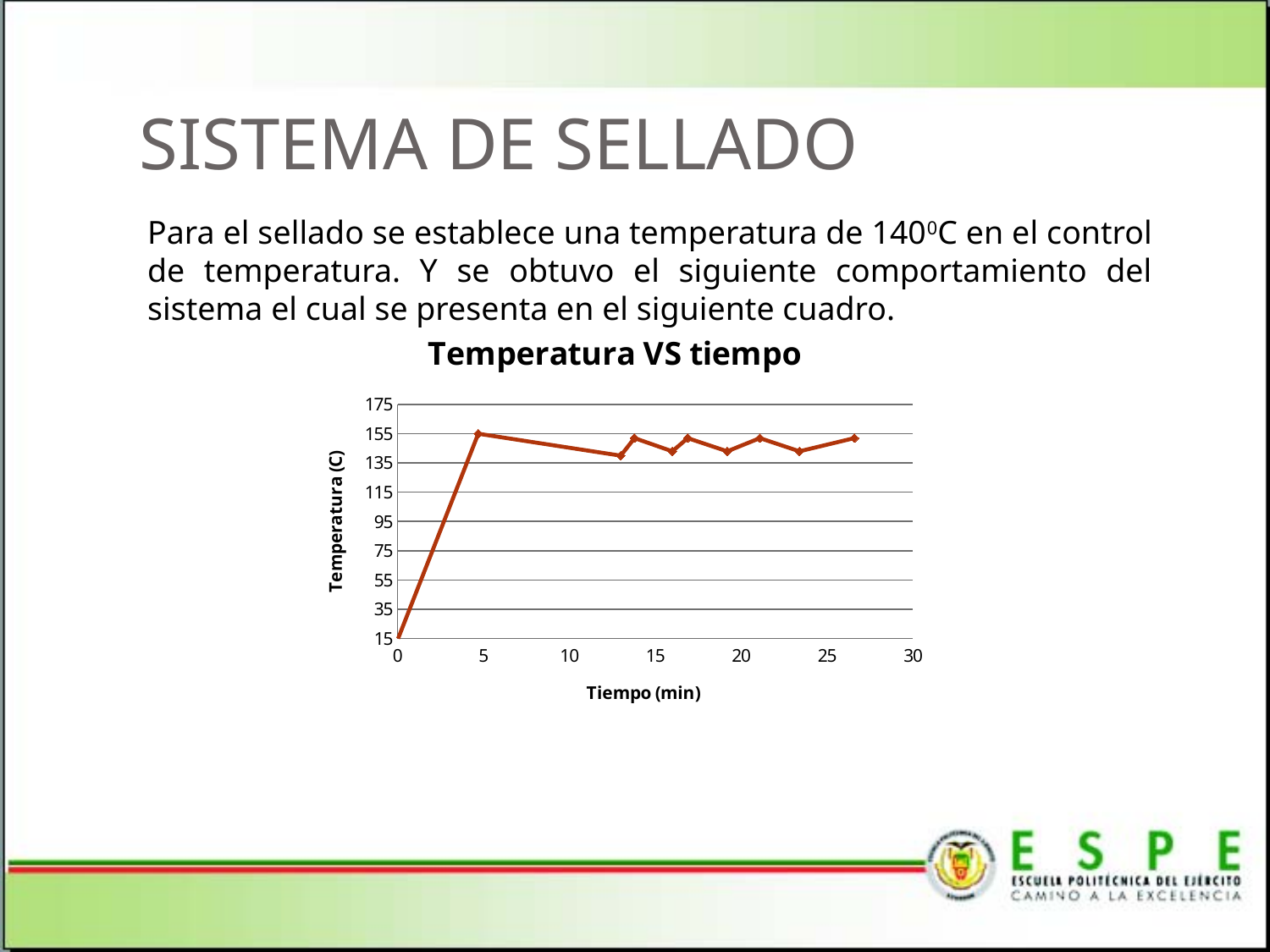
What is the highest value shown on the y axis? 175 What is the label of the x axis of the chart? Tiempo (min) What is the title of the chart? Temperatura VS tiempo Which is larger: the temperature at time 0 or the temperature at about 5 minutes? about 5 minutes What kind of chart is shown on the slide? line chart Is the temperature at time 0 greater or less than 35? less At what time is the temperature lowest? 0 minutes Does the temperature rise or fall between 0 and 5 minutes? rises Is the temperature at about 26 minutes greater or less than 135? greater Is the temperature at about 13 minutes greater or less than 115? greater